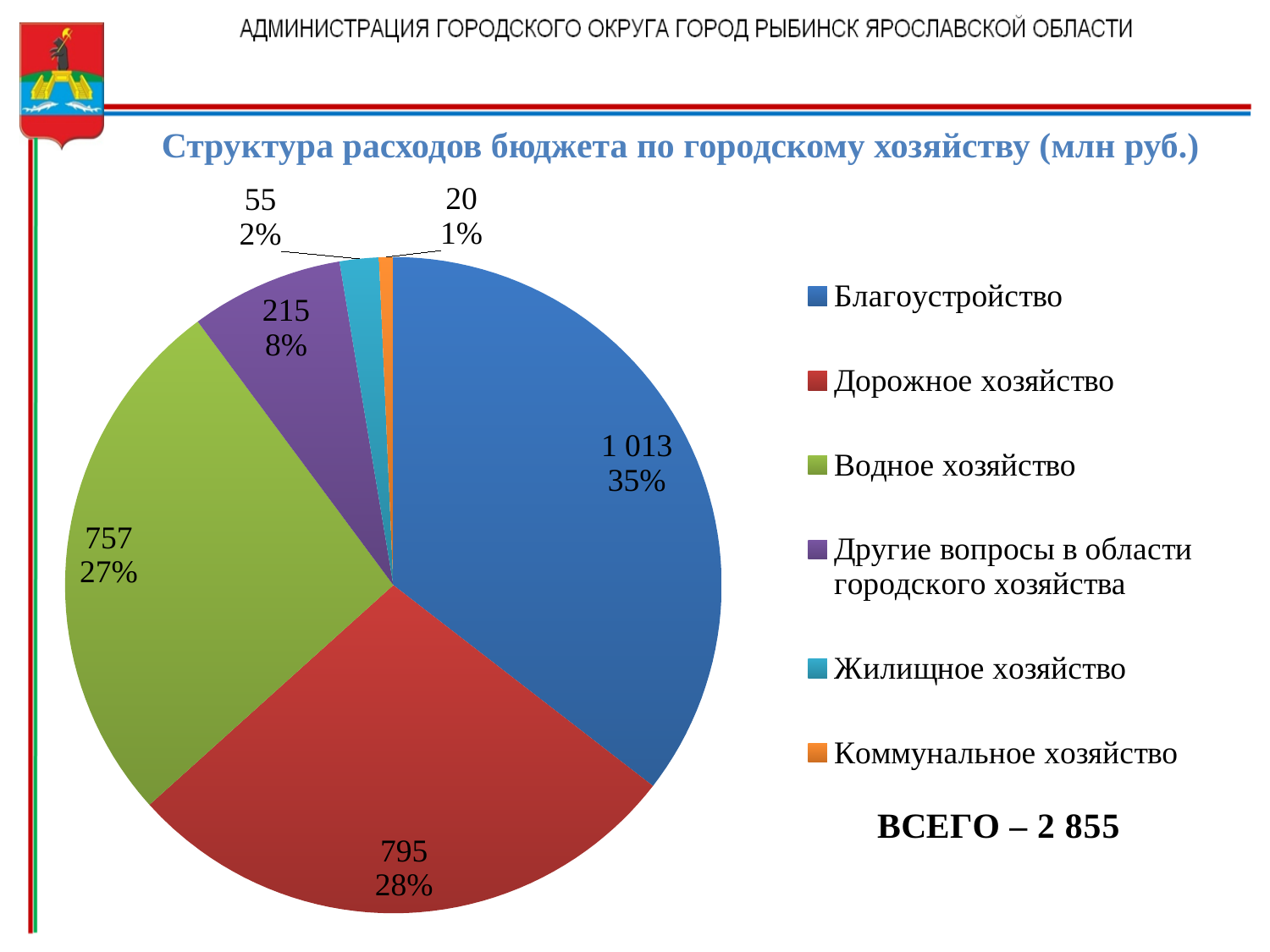
Which category has the smallest slice of the pie? Коммунальное хозяйство How many categories does the pie chart have? 6 What share of the pie does Жилищное хозяйство represent? 2% What is the value for Благоустройство? 1 013 What is the difference between the values for Благоустройство and Дорожное хозяйство? 218 What type of chart is shown on the slide? Pie chart What is the value for Водное хозяйство? 757 What is the value for Другие вопросы в области городского хозяйства? 215 Which category has the largest slice of the pie? Благоустройство What is the value for Дорожное хозяйство? 795 What is the title of the chart? Структура расходов бюджета по городскому хозяйству (млн руб.) What share of the pie does Водное хозяйство represent? 27%